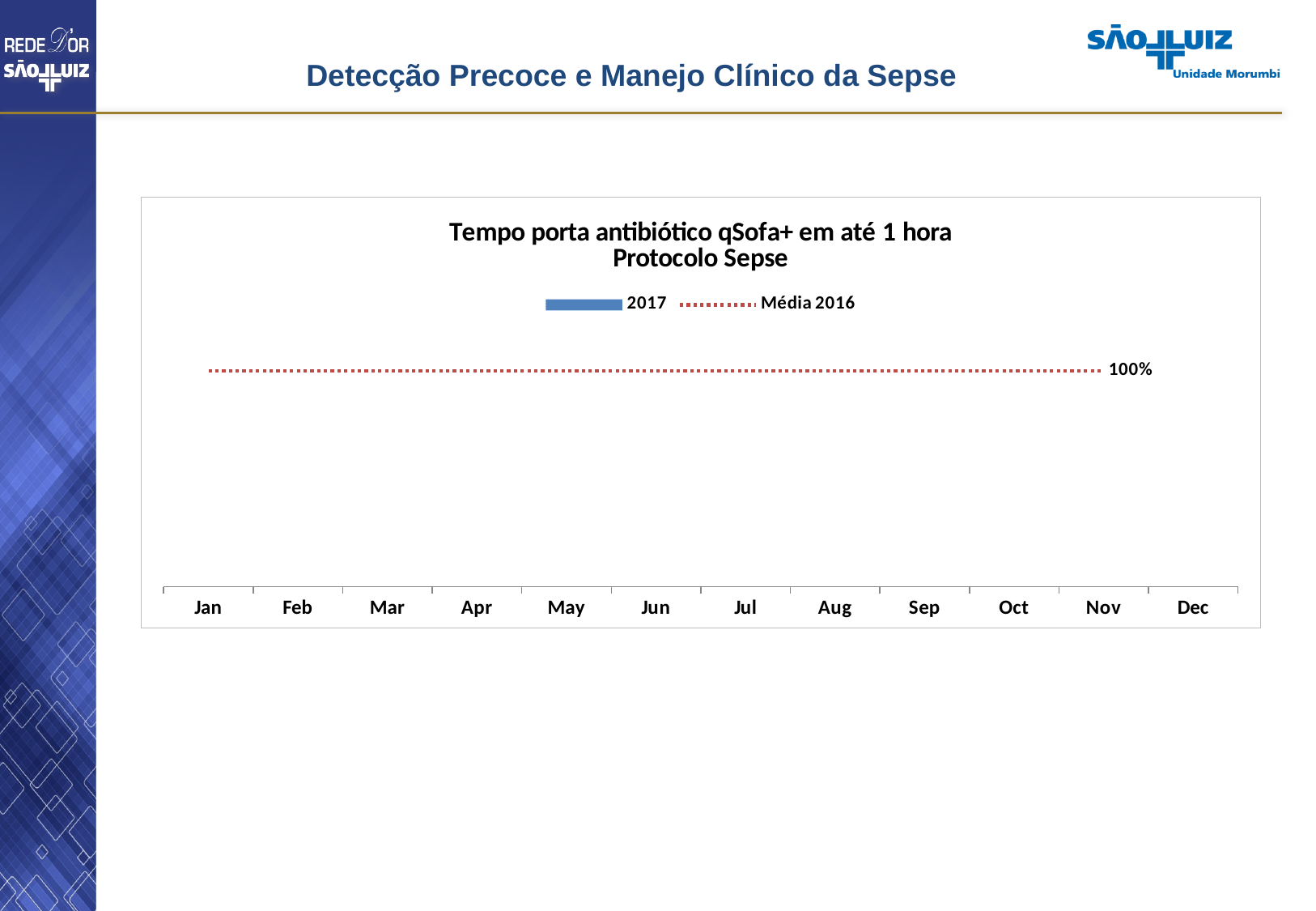
What value is labelled on the dotted Média 2016 line? 100% What is the first category on the x axis? Jan Which series is drawn as a dotted line? Média 2016 Which series is represented by a solid blue bar in the legend? 2017 How many month categories are shown on the x axis? 12 How many series does the legend list? 2 Does the Média 2016 line rise, fall or stay flat across the months? stays flat